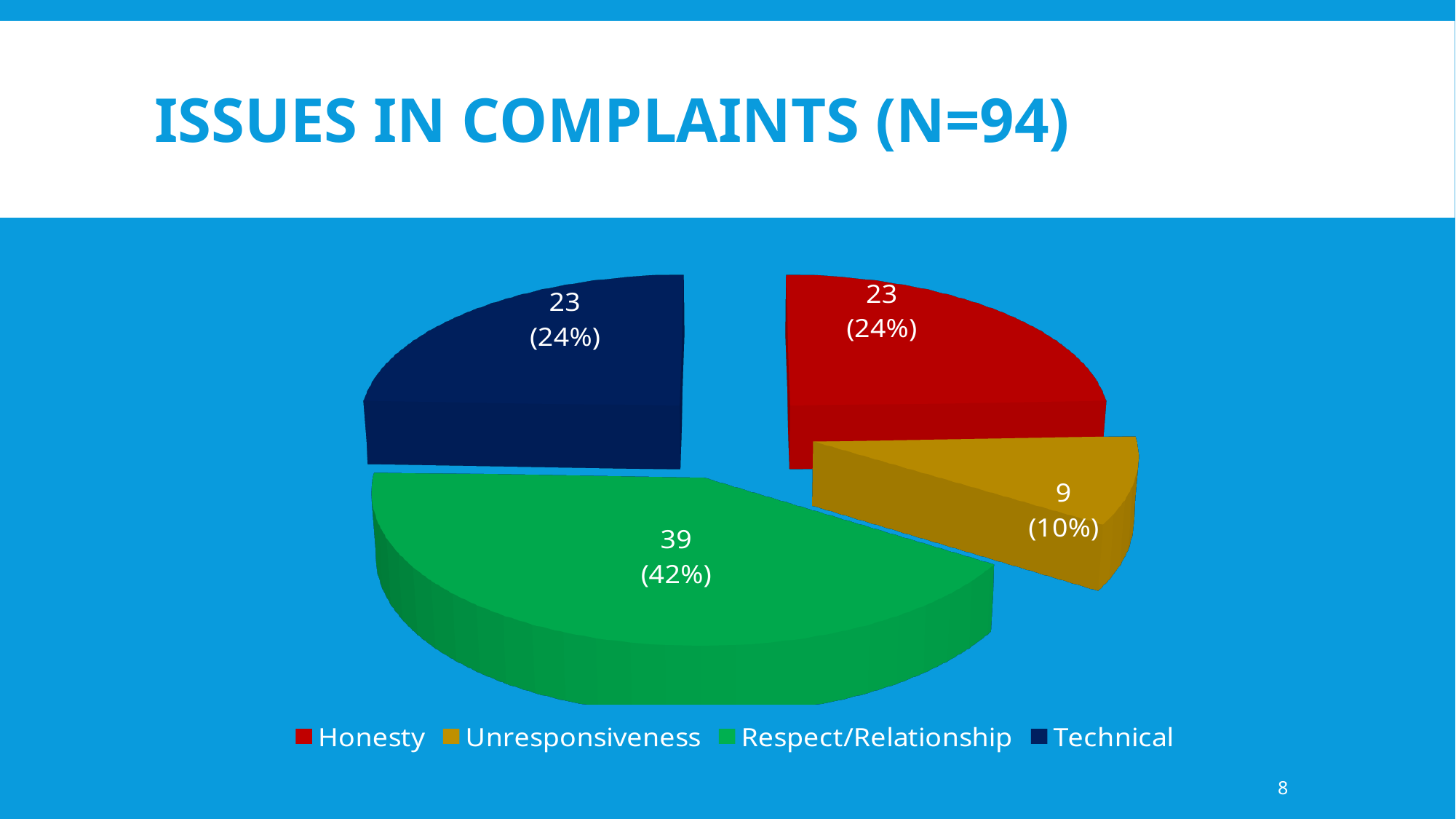
What kind of chart is shown on the slide? pie chart How many complaints are in the Respect/Relationship slice? 39 What is the title of the chart slide? ISSUES IN COMPLAINTS (N=94) What percentage of complaints does the Unresponsiveness slice represent? 10% Which issue category has the smallest slice? Unresponsiveness How many complaints are in the Honesty slice? 23 What percentage of complaints does the Technical slice represent? 24% How many categories does the legend list? 4 What colour is the Respect/Relationship slice? green Which has more complaints, Technical or Unresponsiveness? Technical What is the difference in the number of complaints between Respect/Relationship and Unresponsiveness? 30 Which issue category has the largest slice? Respect/Relationship